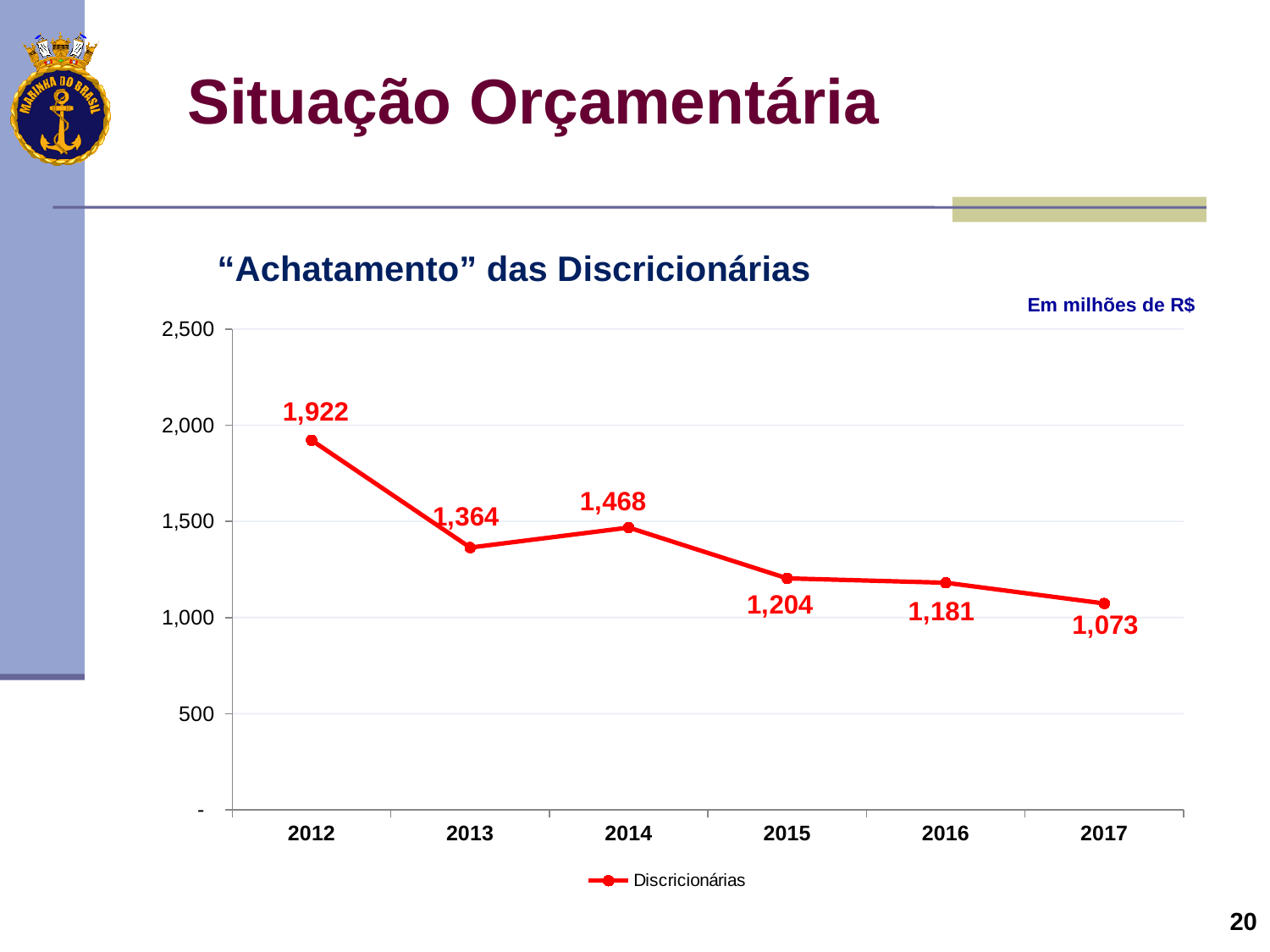
What is the difference between the values for 2015 and 2017? 131 Which is larger, the value for 2013 or the value for 2014? 2014 What kind of chart is shown? line chart How many years are plotted on the x axis? 6 What is the overall trend of the values from 2012 to 2017? falling What is the value for 2017? 1,073 Which year has the highest value? 2012 What is the difference between the values for 2012 and 2013? 558 What is the value for 2014? 1,468 Is the value for 2016 greater or less than 1,500? less What is the value for 2012? 1,922 Which year has the lowest value? 2017